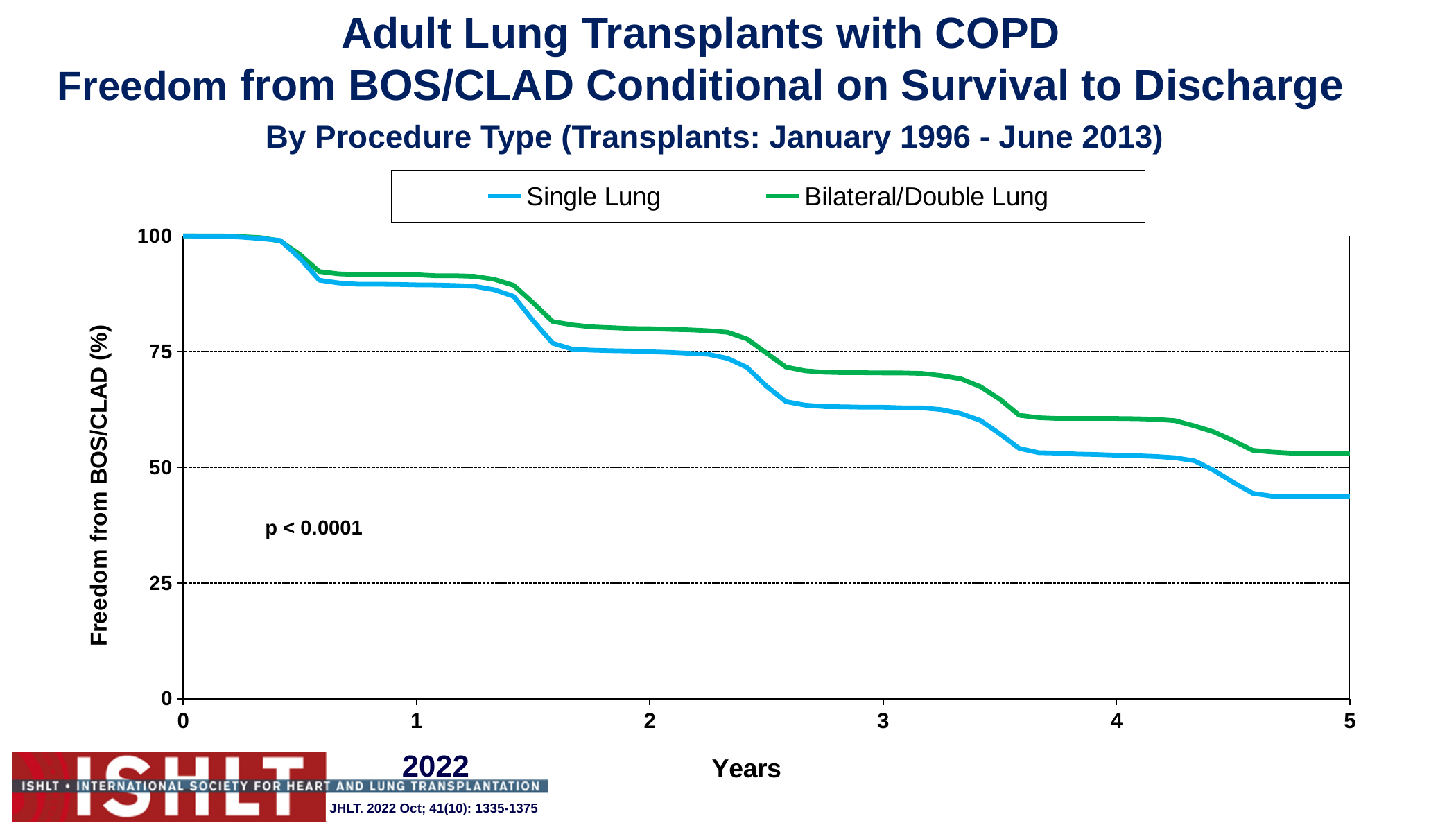
What kind of chart is shown on the slide? line chart Is the value for Bilateral/Double Lung at 2 years greater or less than 75? greater How many series does the legend list? 2 At 5 years, which series has the higher freedom from BOS/CLAD, Single Lung or Bilateral/Double Lung? Bilateral/Double Lung Is the value for Single Lung at 3 years greater or less than 75? less Do the values for the Bilateral/Double Lung series rise or fall as years increase? fall What is the value of the Single Lung series at 0 years? 100 What p-value is printed on the chart? p < 0.0001 Which series is shown in green in the legend? Bilateral/Double Lung At 4 years, which series has the lower freedom from BOS/CLAD, Single Lung or Bilateral/Double Lung? Single Lung Is the value for Single Lung at 5 years greater or less than 50? less